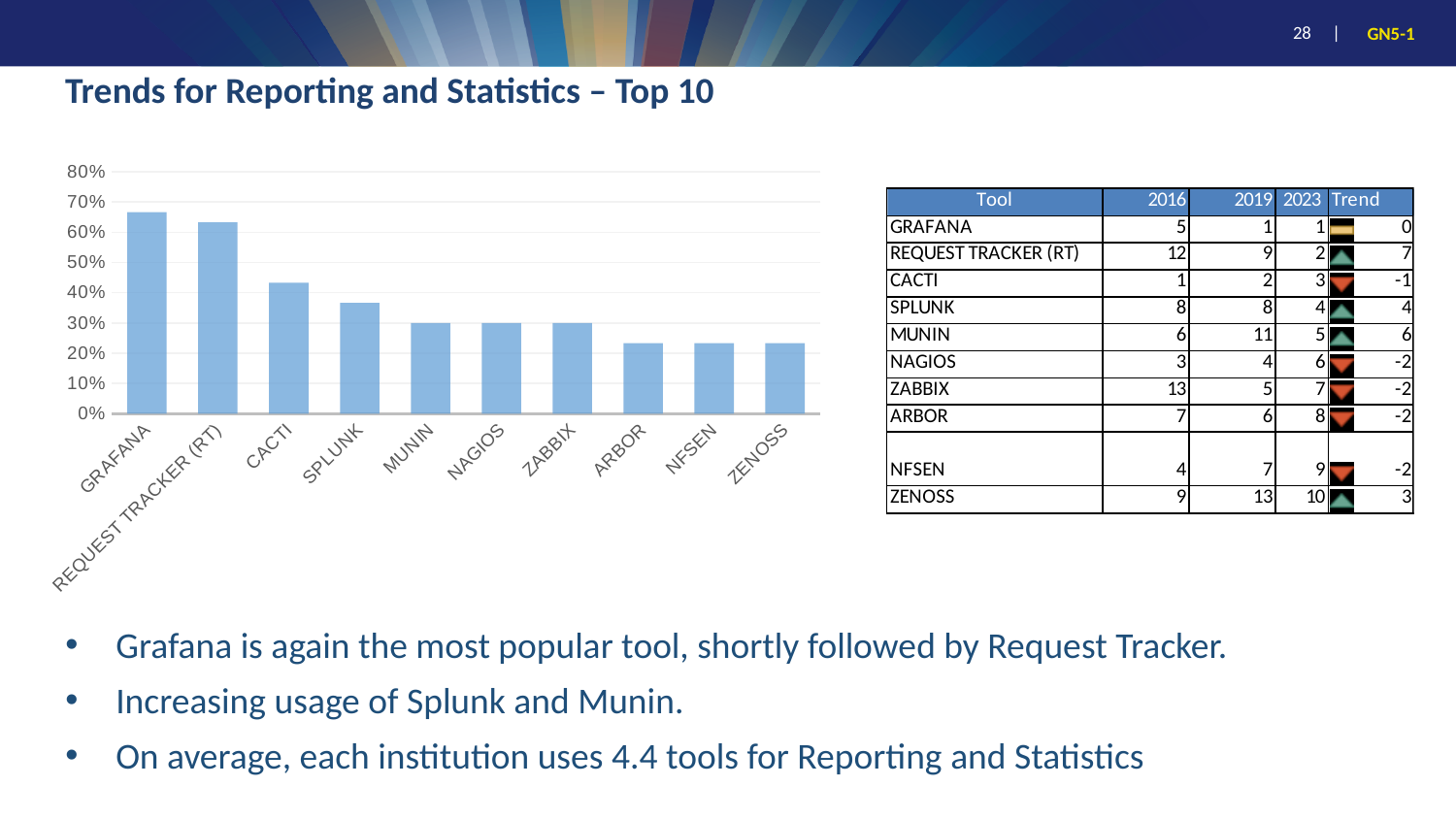
What kind of chart is shown on the slide? bar chart Which tool has the highest bar in the chart? GRAFANA Do the bar values generally rise or fall from left to right along the x axis? fall Which has the larger value, CACTI or SPLUNK? CACTI How many tools are plotted in the bar chart? 10 Is the value for SPLUNK greater or less than 40%? less Is the value for CACTI greater or less than 40%? greater Is the value for ARBOR greater or less than 30%? less Which has the larger value, GRAFANA or CACTI? GRAFANA What is the title of the slide containing the chart? Trends for Reporting and Statistics – Top 10